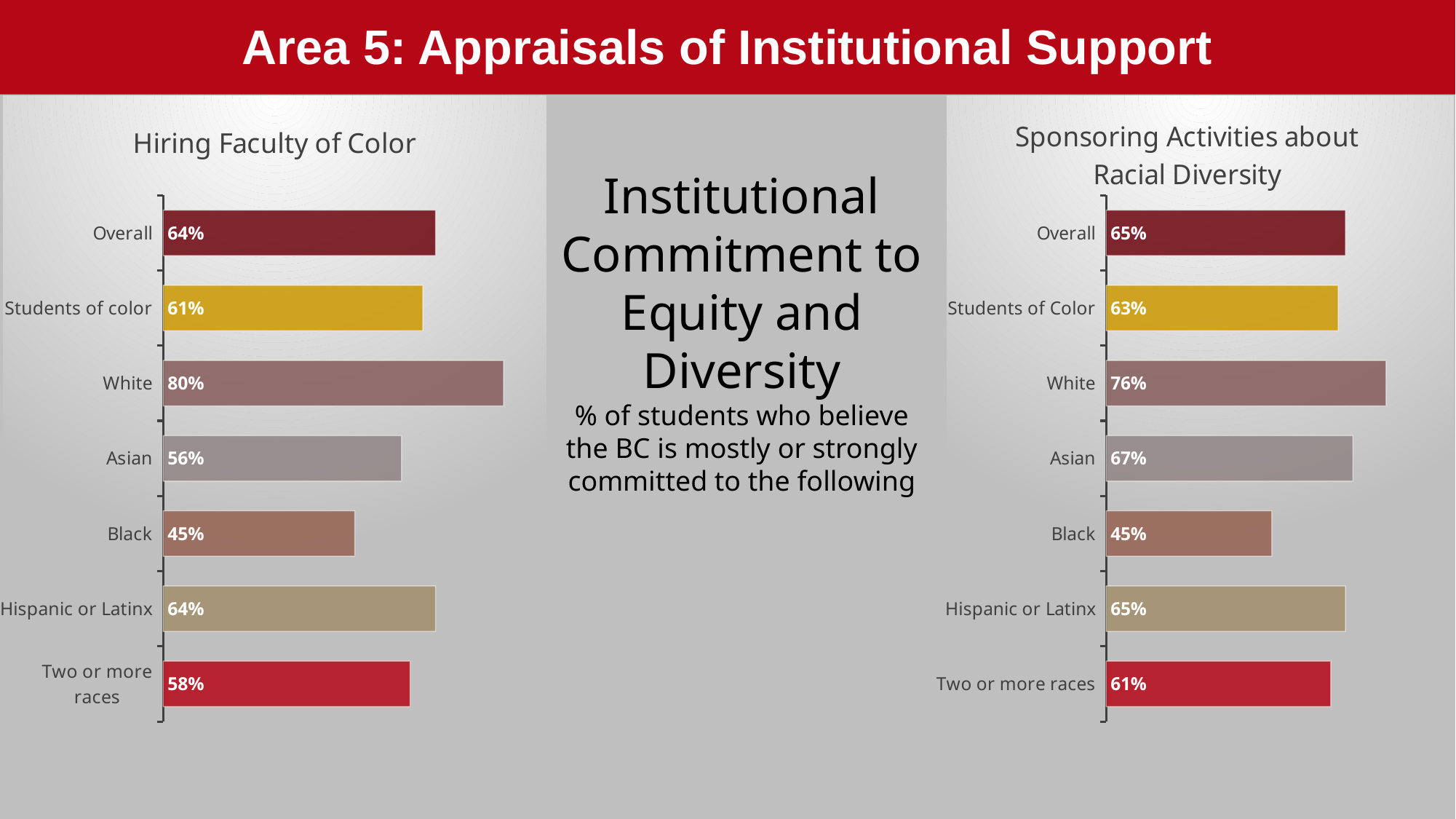
What kind of chart is the 'Sponsoring Activities about Racial Diversity' chart? Bar chart In the 'Hiring Faculty of Color' chart, which is larger: the value for Asian or the value for Two or more races? Two or more races In the 'Hiring Faculty of Color' chart, which category has the lowest value? Black What is the title of the chart on the left side of the slide? Hiring Faculty of Color How many categories are shown in the 'Hiring Faculty of Color' chart? 7 In the 'Hiring Faculty of Color' chart, what is the value for Hispanic or Latinx? 64% In the 'Hiring Faculty of Color' chart, what is the difference between the values for White and Black? 35% In the 'Hiring Faculty of Color' chart, what is the value for White? 80% In the 'Sponsoring Activities about Racial Diversity' chart, which category has the highest value? White In the 'Sponsoring Activities about Racial Diversity' chart, which is larger: the value for Hispanic or Latinx or the value for Two or more races? Hispanic or Latinx In the 'Sponsoring Activities about Racial Diversity' chart, what is the value for Asian? 67% In the 'Sponsoring Activities about Racial Diversity' chart, what is the difference between the values for Overall and Students of Color? 2%